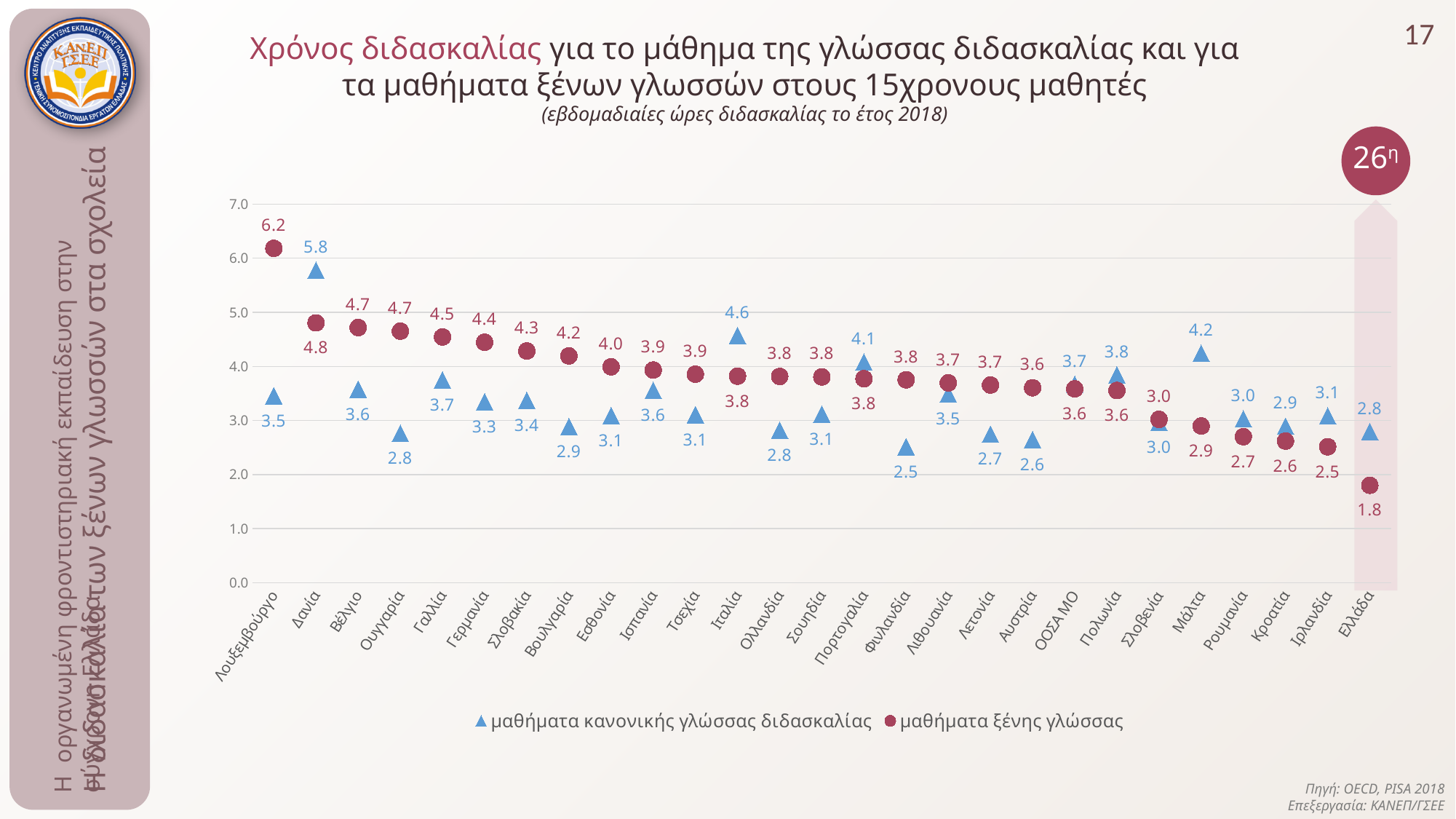
For Ιταλία, which series has the larger value: μαθήματα κανονικής γλώσσας διδασκαλίας or μαθήματα ξένης γλώσσας? μαθήματα κανονικής γλώσσας διδασκαλίας Which category has the lowest value in the series μαθήματα κανονικής γλώσσας διδασκαλίας? Φινλανδία Which category has the highest value in the series μαθήματα ξένης γλώσσας? Λουξεμβούργο What is the value for Ιταλία in the series μαθήματα κανονικής γλώσσας διδασκαλίας? 4.6 Do the values of the series μαθήματα ξένης γλώσσας rise or fall from left to right along the x axis? fall How many series does the legend list? 2 What is the value for Ελλάδα in the series μαθήματα ξένης γλώσσας? 1.8 How many categories are shown on the x axis? 27 Which category has the lowest value in the series μαθήματα ξένης γλώσσας? Ελλάδα What is the value for Δανία in the series μαθήματα κανονικής γλώσσας διδασκαλίας? 5.8 What is the value for ΟΟΣΑ ΜΟ in the series μαθήματα ξένης γλώσσας? 3.6 What is the difference between the two series values for Ελλάδα? 1.0